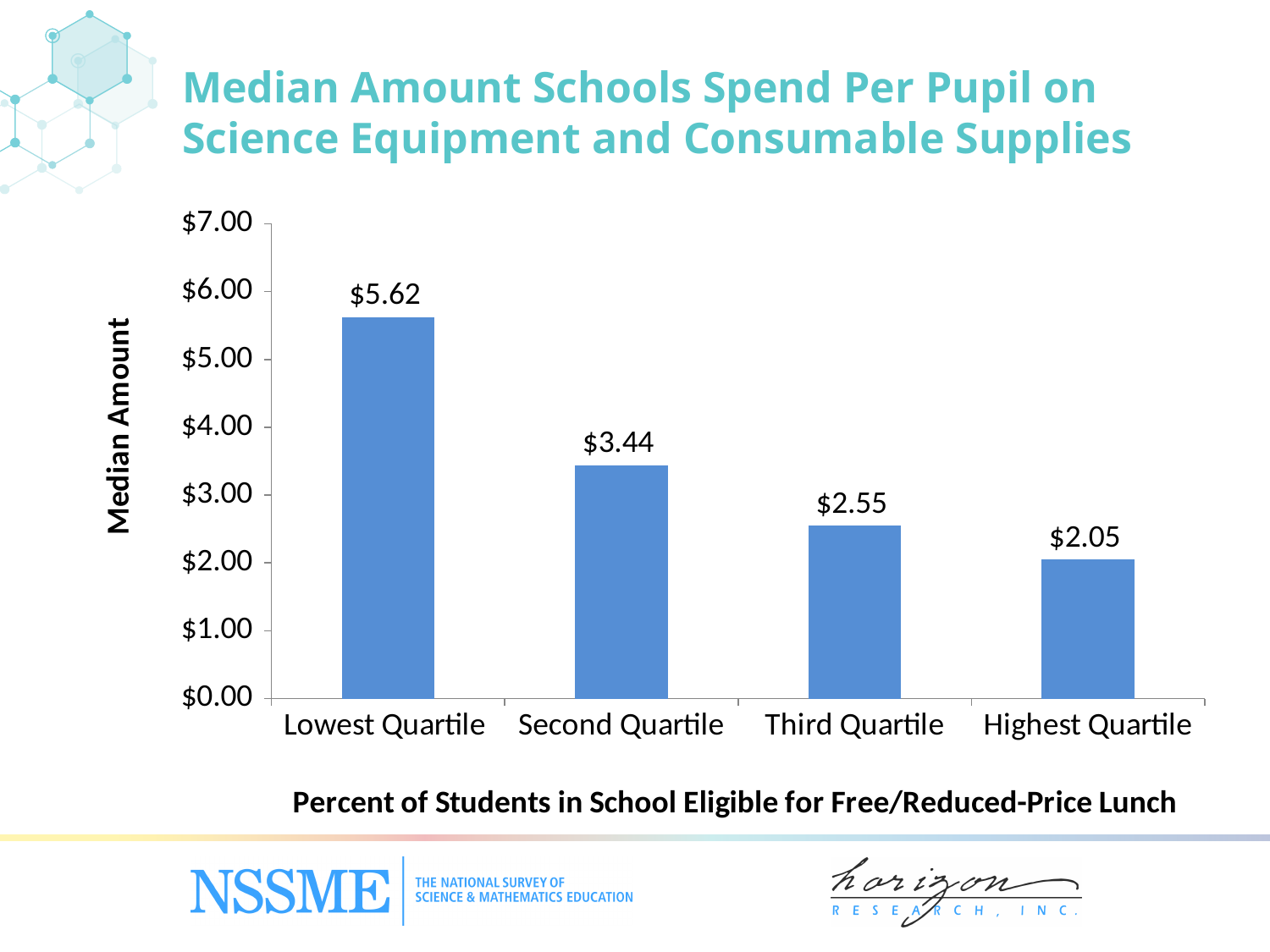
How many quartile categories are shown on the chart? 4 Do the median amounts rise or fall moving from the Lowest Quartile to the Highest Quartile? Fall What is the difference between the median amounts for the Second Quartile and the Third Quartile? $0.89 What is the difference between the median amounts for the Lowest Quartile and the Highest Quartile? $3.57 Which has a larger median amount, the Second Quartile or the Third Quartile? Second Quartile What is the median amount spent per pupil for schools in the Second Quartile? $3.44 What is the median amount spent per pupil for schools in the Highest Quartile? $2.05 What kind of chart is shown on the slide? Bar chart What is the median amount spent per pupil for schools in the Lowest Quartile? $5.62 What is the median amount spent per pupil for schools in the Third Quartile? $2.55 Which quartile has the lowest median amount spent per pupil? Highest Quartile Which quartile has the highest median amount spent per pupil? Lowest Quartile